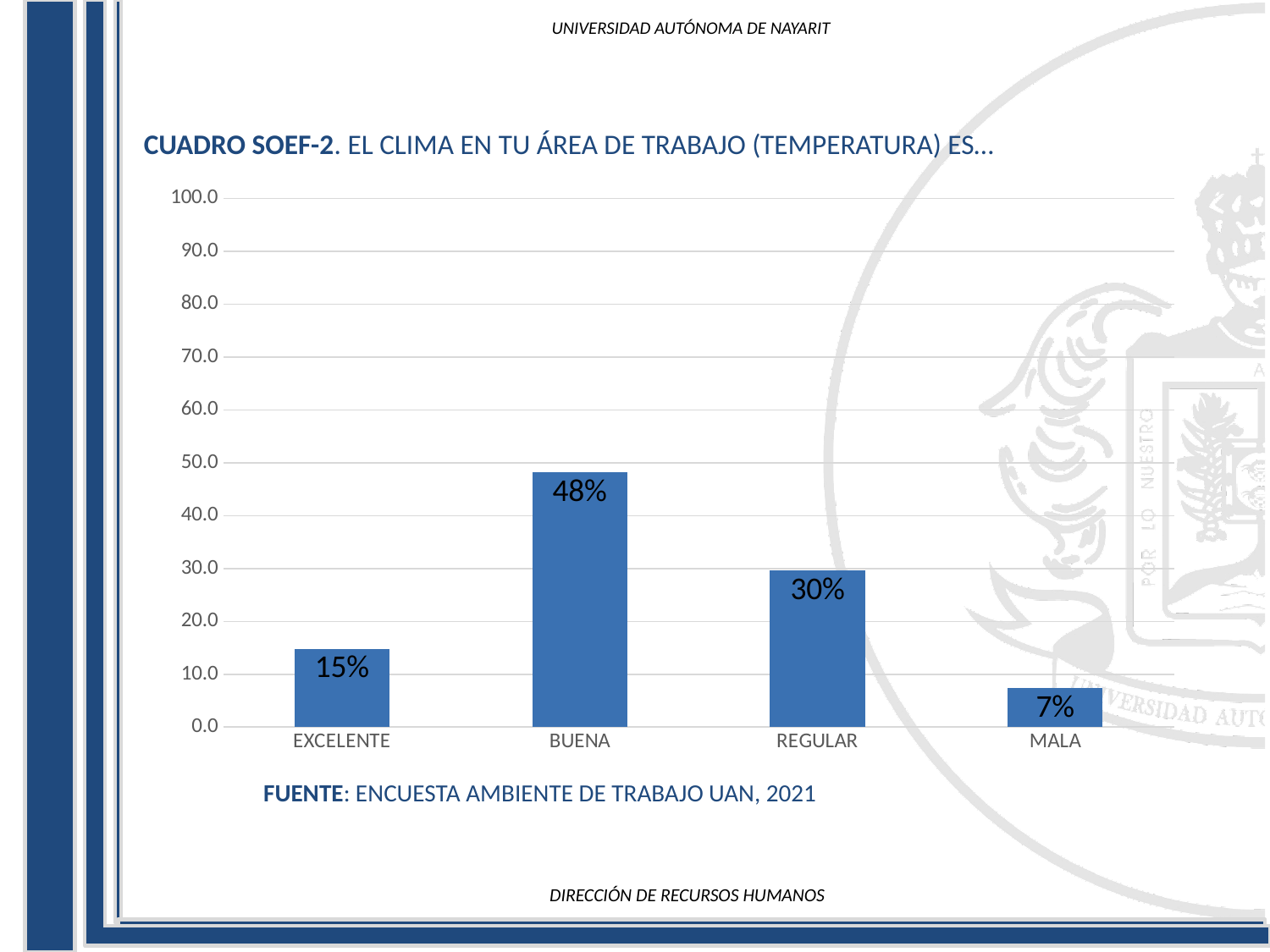
Which is larger, the value for EXCELENTE or the value for REGULAR? REGULAR How many categories are shown on the x axis? 4 What is the value for MALA? 7% What is the value for REGULAR? 30% Which category has the lowest value? MALA What source is cited below the chart? ENCUESTA AMBIENTE DE TRABAJO UAN, 2021 What is the value for EXCELENTE? 15% Is the value for BUENA greater or less than 50.0 on the axis? less What is the value for BUENA? 48% Which category has the highest value? BUENA What kind of chart is shown on the slide? bar chart What is the difference between the values for BUENA and REGULAR? 18%